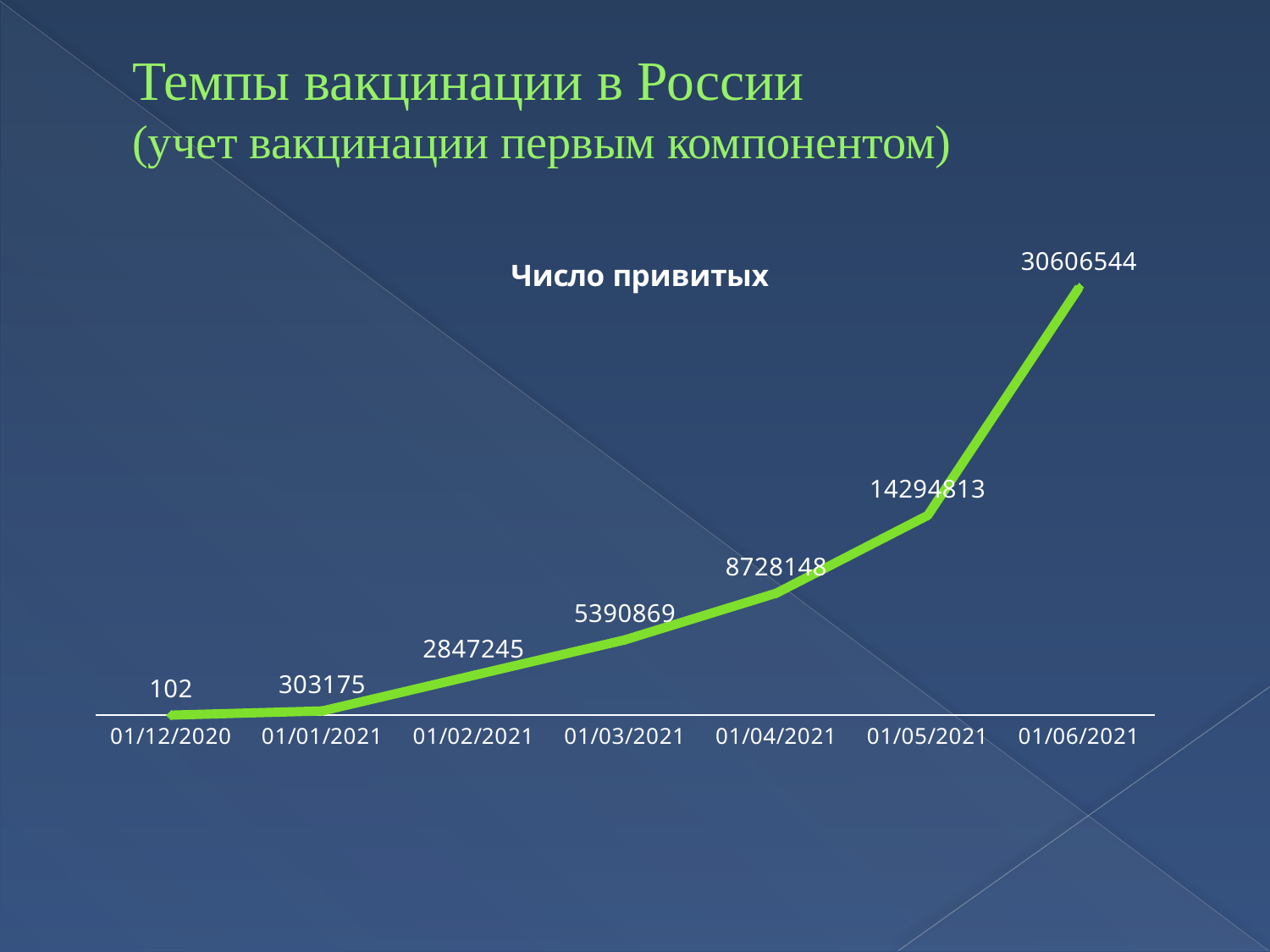
What is the title of the chart? Число привитых Which is larger, the value for 01/03/2021 or the value for 01/01/2021? 01/03/2021 What is the value for 01/12/2020? 102 Which date has the highest value? 01/06/2021 What type of chart is shown on the slide? line chart How many data points are plotted on the chart? 7 What is the value for 01/02/2021? 2847245 What is the value for 01/06/2021? 30606544 Which date has the lowest value? 01/12/2020 Do the values rise or fall from 01/12/2020 to 01/06/2021? rise What is the difference between the values for 01/06/2021 and 01/05/2021? 16311731 What is the value for 01/04/2021? 8728148